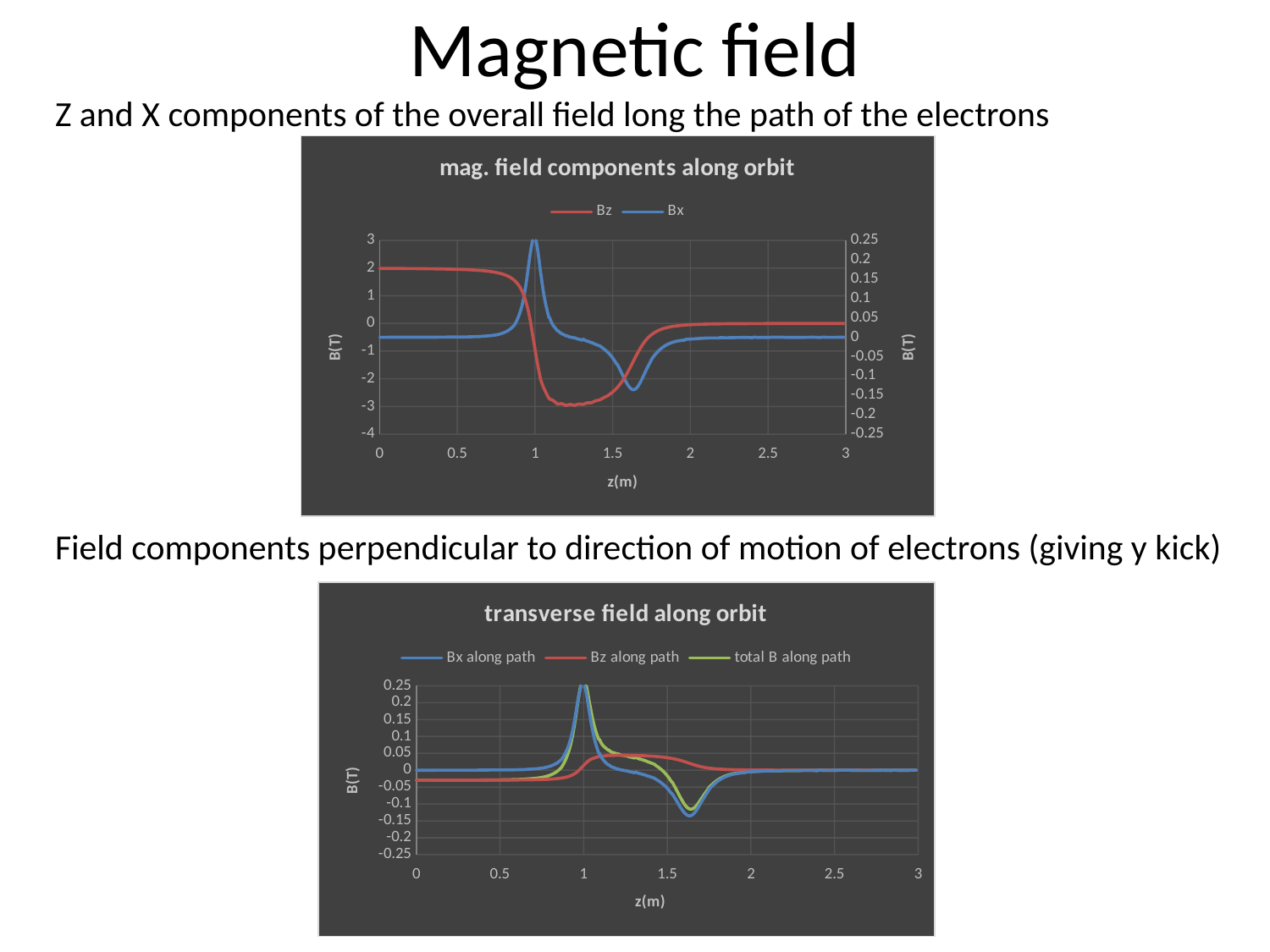
In the top chart "mag. field components along orbit", is the minimum value of Bz (near z = 1.2) on the left axis greater or less than -2? less How many series does the legend of the bottom chart "transverse field along orbit" list? 3 In the top chart "mag. field components along orbit", does Bz rise or fall between z = 0.5 and z = 1.2? fall In the bottom chart "transverse field along orbit", is the lowest value of Bx along path (near z = 1.65) greater or less than -0.1? less How many series does the legend of the top chart "mag. field components along orbit" list? 2 In the top chart "mag. field components along orbit", is the value of Bz at z = 0 on the left axis greater or less than 1? greater What kind of chart is the top chart titled "mag. field components along orbit"? line chart What is the x-axis label of the top chart "mag. field components along orbit"? z(m) In the bottom chart "transverse field along orbit", which series is drawn in green? total B along path In the bottom chart "transverse field along orbit", does Bx along path rise or fall between z = 1 and z = 1.6? fall